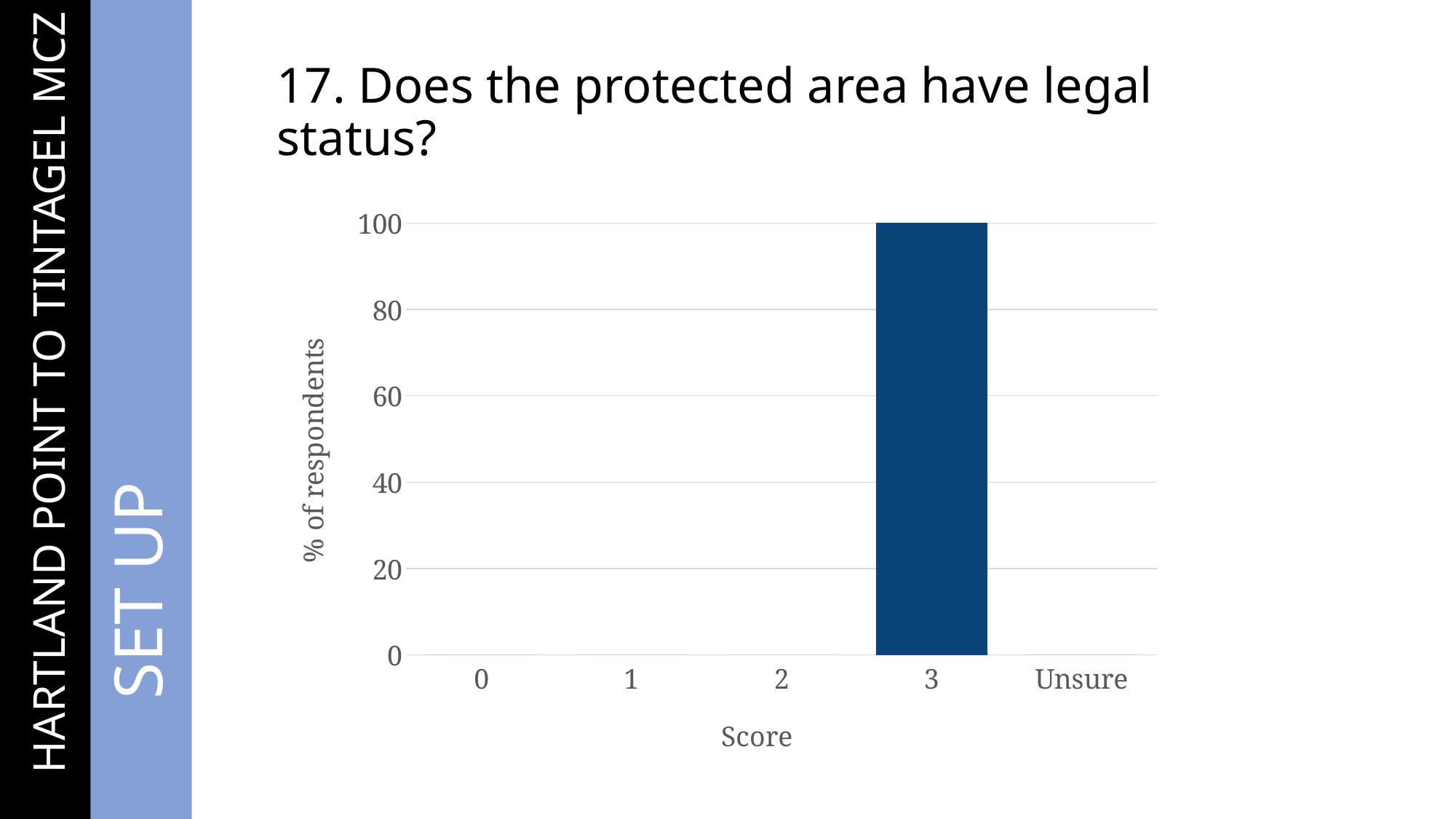
Is the value for score 2 greater or less than 20? less What kind of chart is shown on the slide? bar chart Is the value for score 3 greater or less than 80? greater Which score category has the highest value? 3 What is the value for score 0? 0 Which is larger, the value for score 3 or the value for score 2? score 3 What is the value for Unsure? 0 What is the value for score 3? 100 What is the label of the y axis? % of respondents What is the difference between the value for score 3 and the value for score 1? 100 What is the label of the x axis? Score How many categories are shown on the x axis? 5